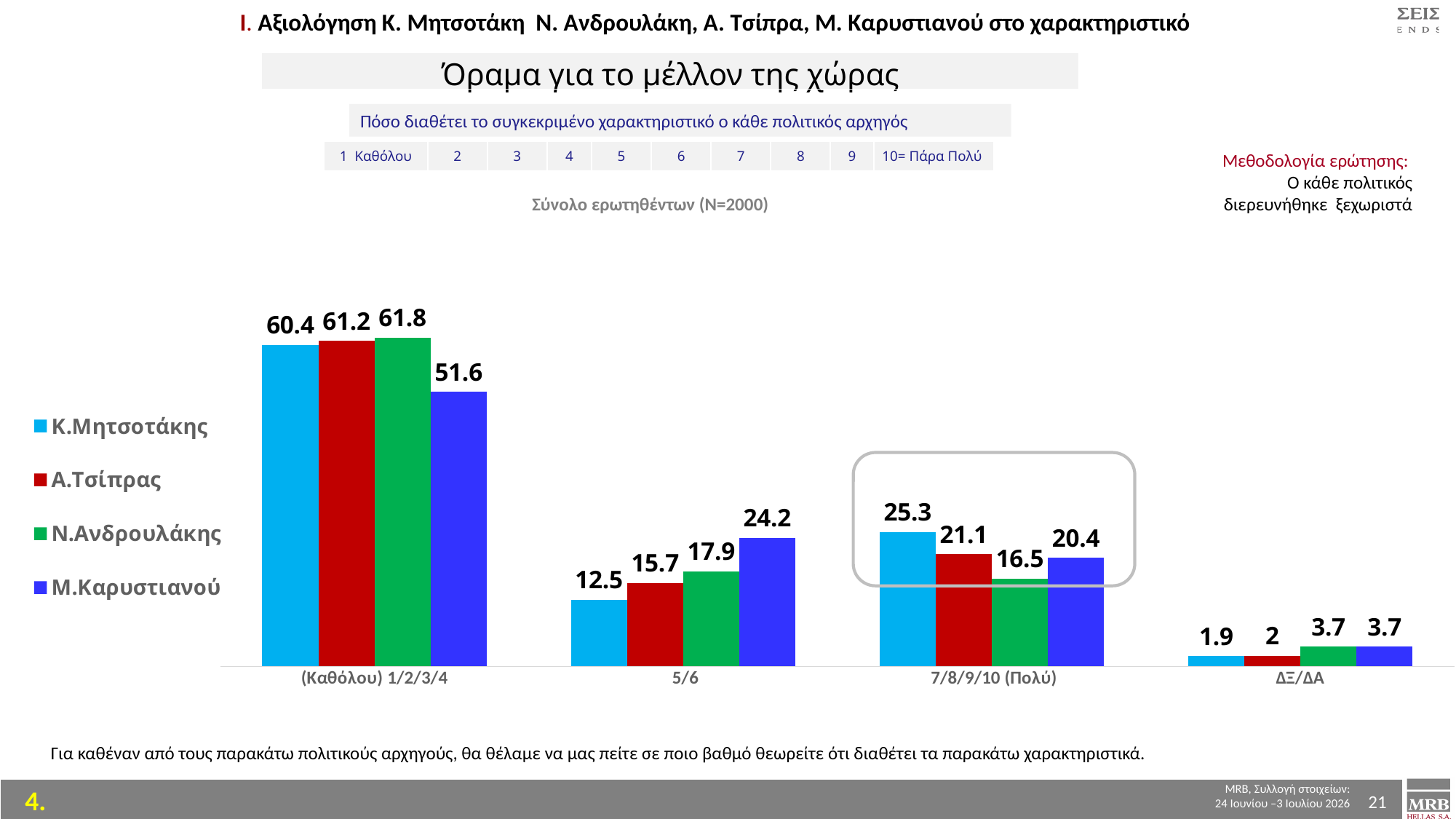
In the 5/6 category, which is larger: the value for Μ.Καρυστιανού or the value for Κ.Μητσοτάκης? Μ.Καρυστιανού What is the value for Α.Τσίπρας in the ΔΞ/ΔΑ category? 2 Which category on the chart is highlighted with a rounded outline? 7/8/9/10 (Πολύ) What is the value for Κ.Μητσοτάκης in the 7/8/9/10 (Πολύ) category? 25.3 Which politician has the highest value in the 7/8/9/10 (Πολύ) category? Κ.Μητσοτάκης How many series does the legend list? 4 What is the value for Μ.Καρυστιανού in the (Καθόλου) 1/2/3/4 category? 51.6 Which politician has the lowest value in the (Καθόλου) 1/2/3/4 category? Μ.Καρυστιανού What is the value for Ν.Ανδρουλάκης in the 5/6 category? 17.9 What kind of chart is shown on the slide? Bar chart How many categories are shown on the x axis of the chart? 4 What is the difference between the values for Κ.Μητσοτάκης and Ν.Ανδρουλάκης in the 7/8/9/10 (Πολύ) category? 8.8